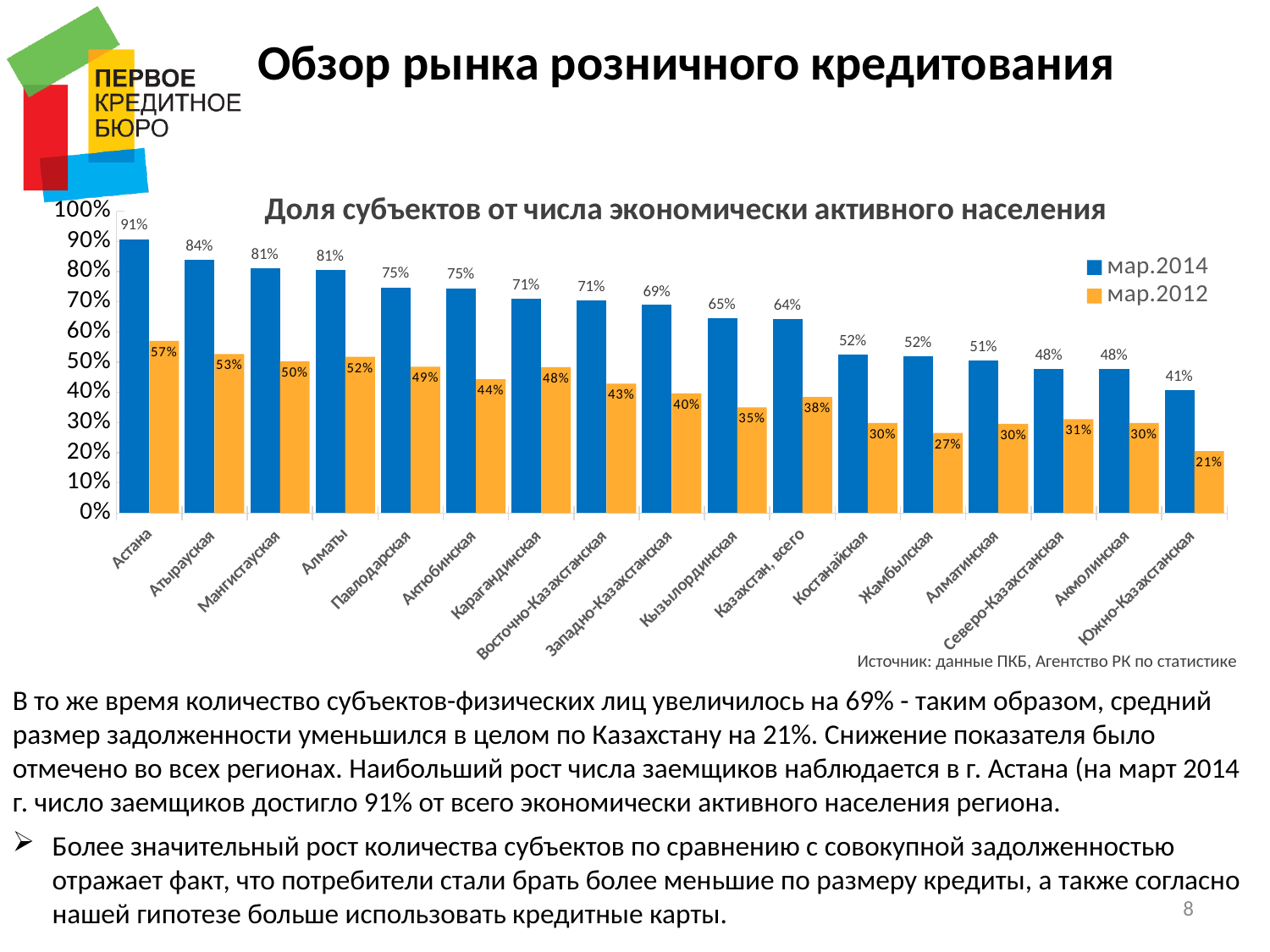
Which category has the highest value in the мар.2014 series? Астана How many series does the legend list? 2 What is the title of the chart? Доля субъектов от числа экономически активного населения How many categories are shown on the x axis? 17 What is the value for Астана in the мар.2014 series? 91% What is the value for Казахстан, всего in the мар.2014 series? 64% What kind of chart is shown on the slide? Bar chart What is the difference between the мар.2014 and мар.2012 values for Астана? 34% Which is larger: the мар.2014 value for Павлодарская or the мар.2014 value for Костанайская? Павлодарская Which category has the lowest value in the мар.2012 series? Южно-Казахстанская What is the value for Южно-Казахстанская in the мар.2012 series? 21% What is the value for Жамбылская in the мар.2012 series? 27%